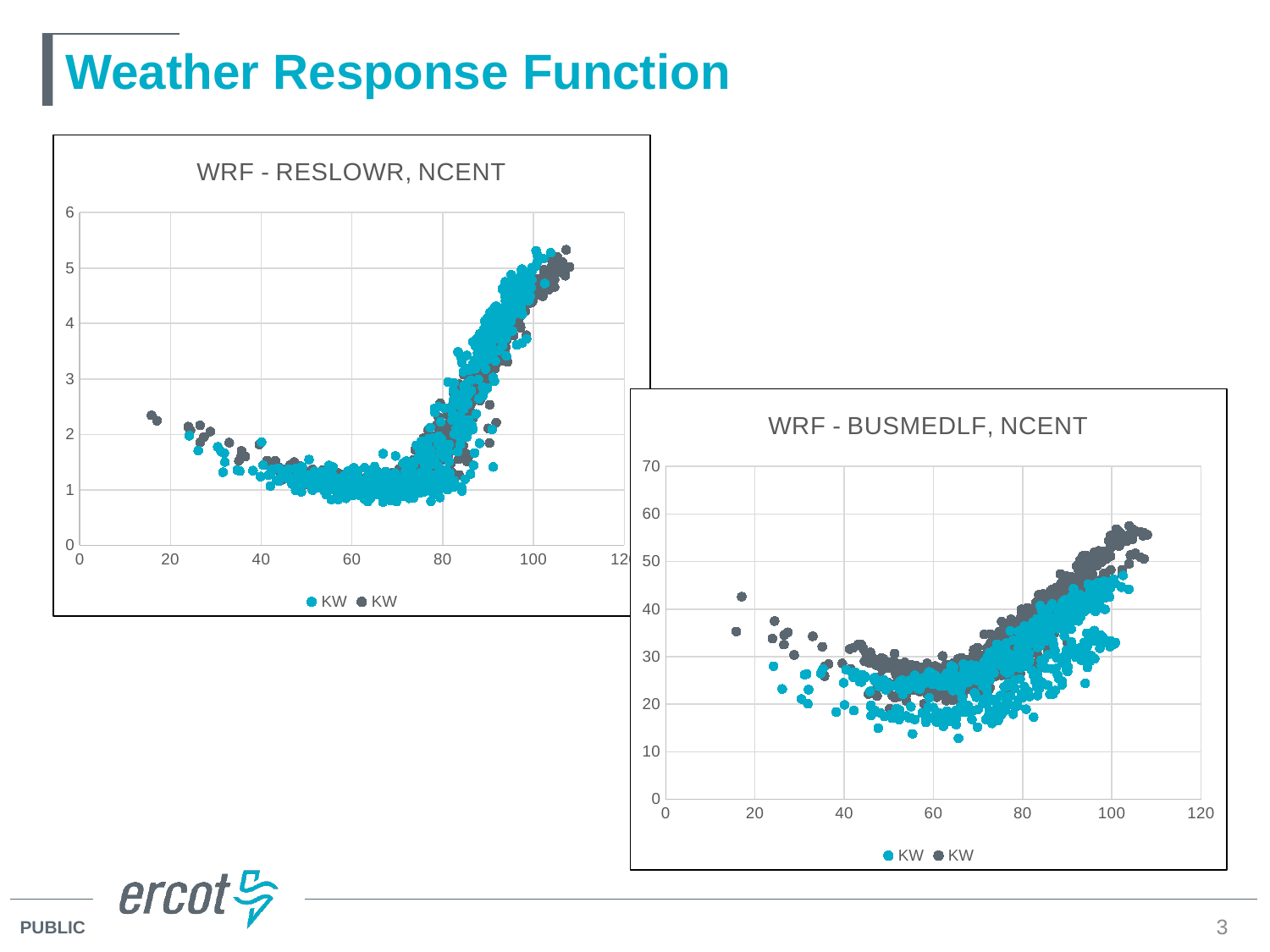
What is the title of the chart on the left of the slide? WRF - RESLOWR, NCENT In the 'WRF - RESLOWR, NCENT' chart, do the values rise or fall as the x axis goes from 80 to 100? rise In the 'WRF - RESLOWR, NCENT' chart, are the values at x = 100 greater or less than 4? greater What kind of chart is the 'WRF - BUSMEDLF, NCENT' chart? scatter chart What label is given to both series in the legend of the 'WRF - BUSMEDLF, NCENT' chart? KW How many series does the legend of the 'WRF - BUSMEDLF, NCENT' chart list? 2 In the 'WRF - RESLOWR, NCENT' chart, are the values at x = 60 greater or less than 2? less How many series does the legend of the 'WRF - RESLOWR, NCENT' chart list? 2 In the 'WRF - BUSMEDLF, NCENT' chart, do the values rise or fall as the x axis goes from 70 to 100? rise In the 'WRF - BUSMEDLF, NCENT' chart, are the values at x = 60 greater or less than 40? less What kind of chart is the 'WRF - RESLOWR, NCENT' chart? scatter chart